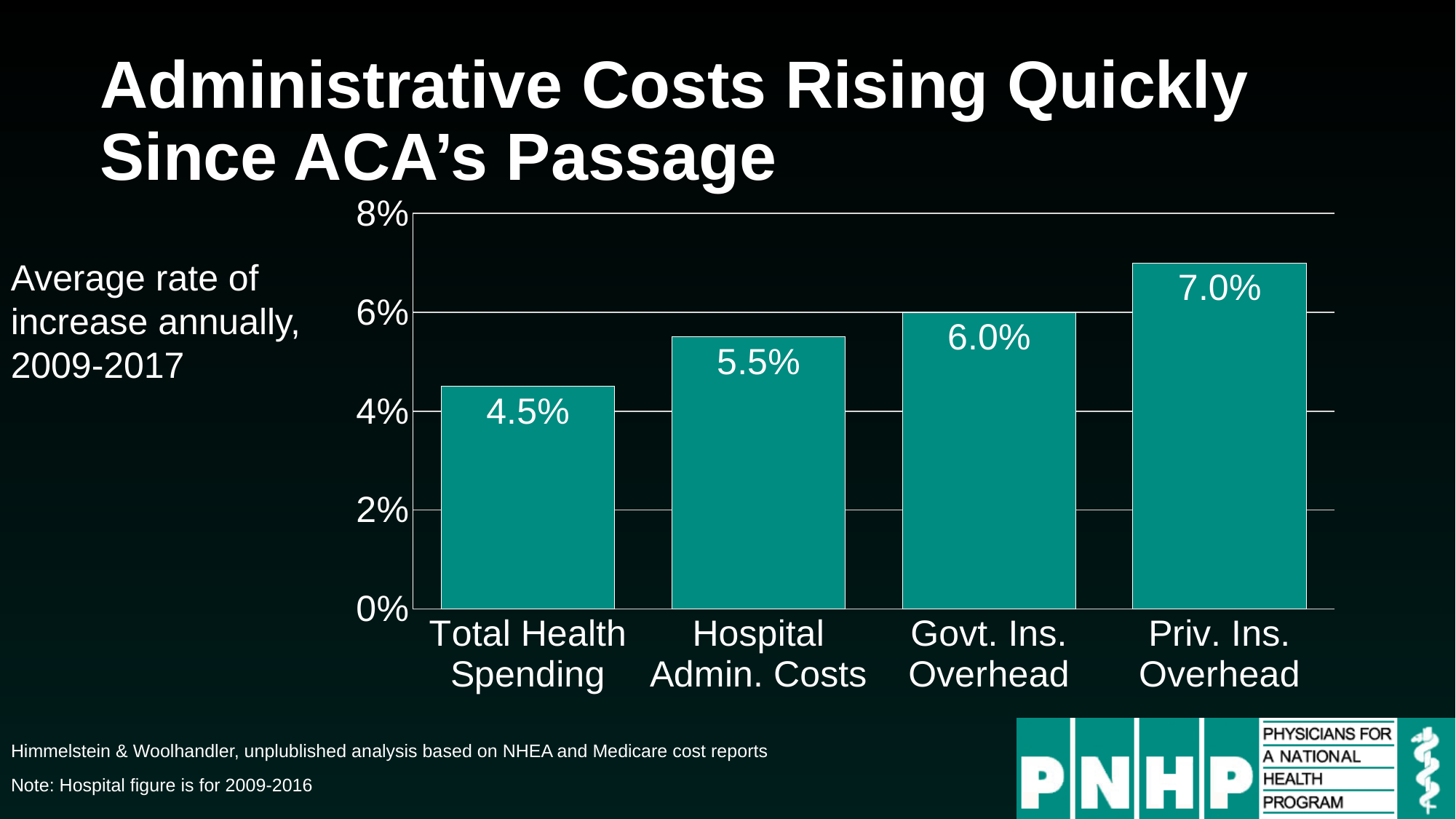
What kind of chart is shown on the slide? Bar chart Which category has the highest average annual rate of increase? Priv. Ins. Overhead How many categories are shown in the chart? 4 Which is larger, the value for Govt. Ins. Overhead or Hospital Admin. Costs? Govt. Ins. Overhead Which category has the lowest average annual rate of increase? Total Health Spending What is the average annual rate of increase for Total Health Spending? 4.5% Is the value for Hospital Admin. Costs greater or less than 4%? greater What is the value shown for Govt. Ins. Overhead? 6.0% What is the value shown for Hospital Admin. Costs? 5.5% What is the difference between the values for Priv. Ins. Overhead and Total Health Spending? 2.5% What is the value shown for Priv. Ins. Overhead? 7.0% Do the values rise or fall from left to right across the categories? Rise